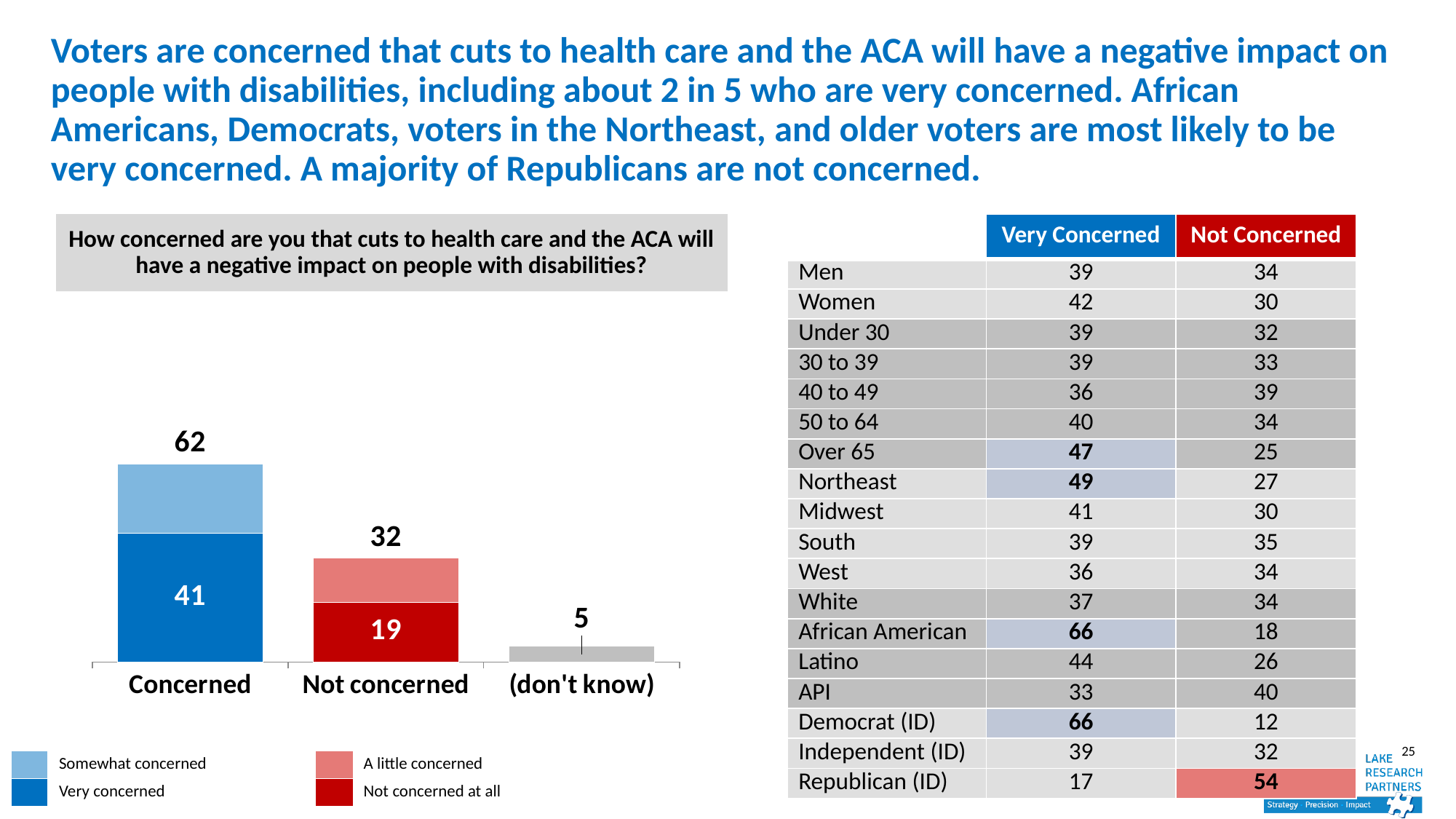
What is the value for '(don't know)'? 5 Which category has the lowest value? (don't know) What is the value of the 'Not concerned at all' segment in the 'Not concerned' bar? 19 Which category has the highest total value? Concerned How many entries does the chart's legend list? 4 What is the value of the 'Somewhat concerned' segment, given the 'Concerned' total of 62 and the 'Very concerned' segment of 41? 21 What is the total value of the 'Concerned' bar? 62 What is the value of the 'Very concerned' segment in the 'Concerned' bar? 41 What kind of chart is shown on the slide? Stacked bar chart Which is larger: the 'Very concerned' segment or the 'Not concerned at all' segment? Very concerned How many categories are shown on the x axis of the chart? 3 What is the difference between the total for 'Concerned' and the total for 'Not concerned'? 30